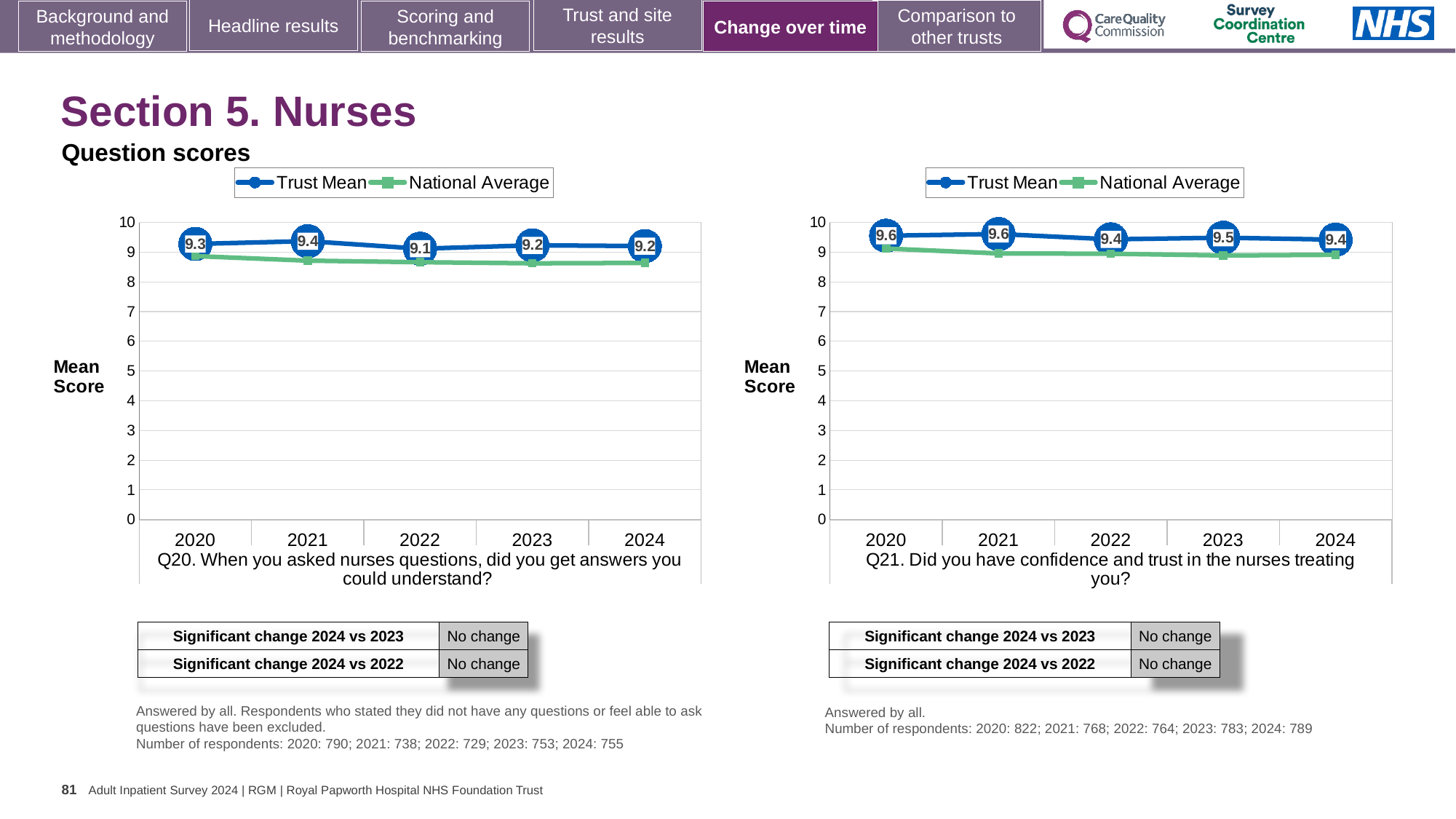
In the Q20 chart (left), what is the Trust Mean score for 2021? 9.4 In the Q21 chart (right), what is the Trust Mean score for 2022? 9.4 In the Q20 chart (left), what is the difference between the Trust Mean scores for 2021 and 2022? 0.3 In the Q20 chart (left), which year has the lowest Trust Mean score? 2022 In the Q21 chart (right), what is the highest Trust Mean score shown? 9.6 How many series does the legend of the Q21 chart (right) list? 2 In the Q21 chart (right), which series is shown in green? National Average How many years are plotted on the x axis of the Q20 chart (left)? 5 What type of chart is used for Q20 (left)? Line chart In the Q20 chart (left), is the National Average for 2024 greater or less than 9? less In the Q21 chart (right), is the Trust Mean score for 2020 higher or lower than for 2024? higher